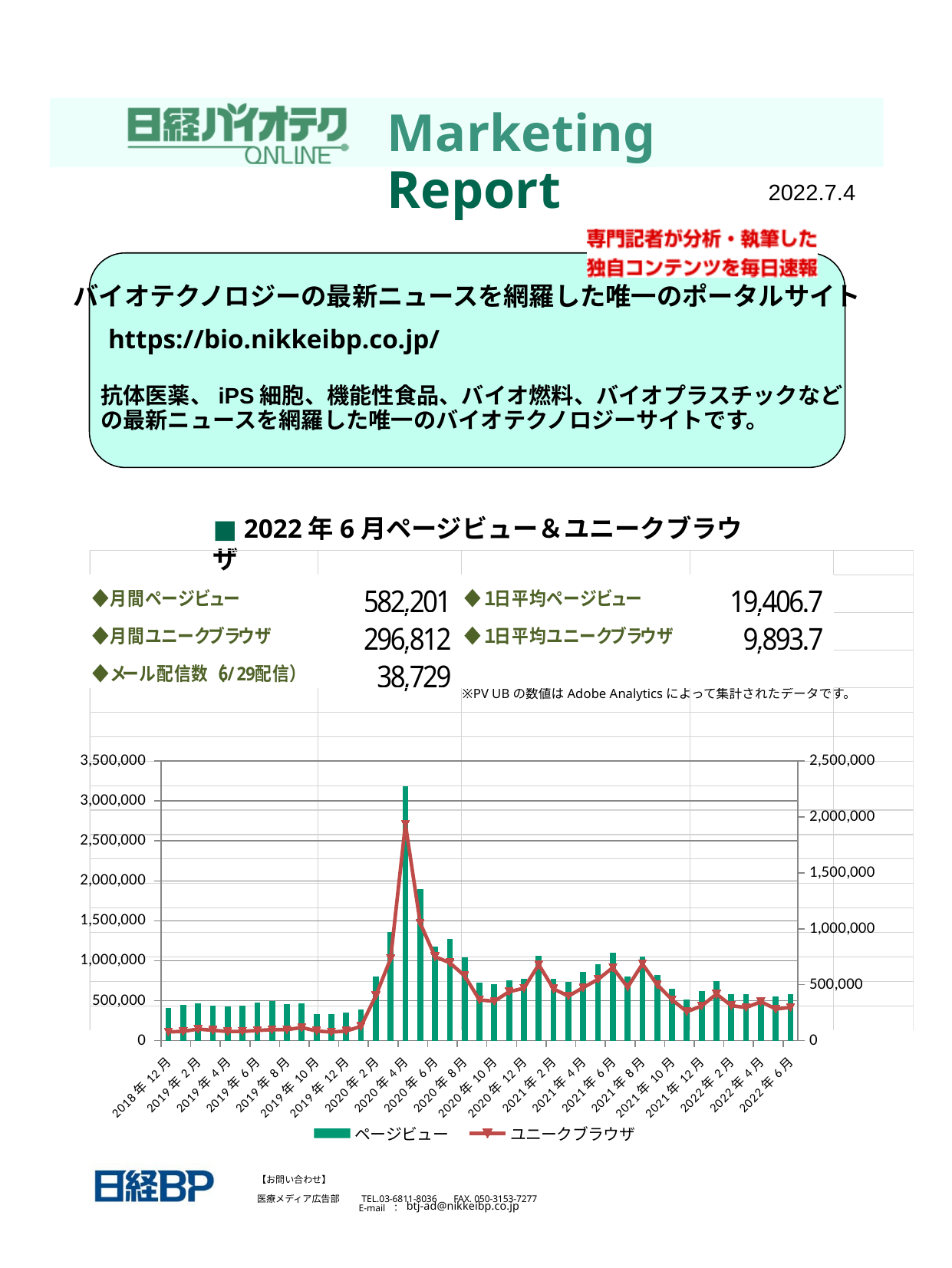
Is the unique browser (ユニークブラウザ) value for 2022年6月 greater or less than 500,000? less What kind of chart is shown on the slide? A combined bar and line chart How many series does the chart legend list? 2 Is the page view (ページビュー) value for 2020年4月 greater or less than 3,000,000? greater Which month has higher page views (ページビュー): 2020年4月 or 2021年8月? 2020年4月 Is the unique browser (ユニークブラウザ) value for 2020年4月 greater or less than 1,500,000? greater What is the maximum value shown on the left vertical axis of the chart? 3,500,000 What are the two series named in the chart legend? ページビュー and ユニークブラウザ Which month has the highest page views (ページビュー) in the chart? 2020年4月 Do page views (ページビュー) rise or fall from 2020年4月 to 2020年10月? fall